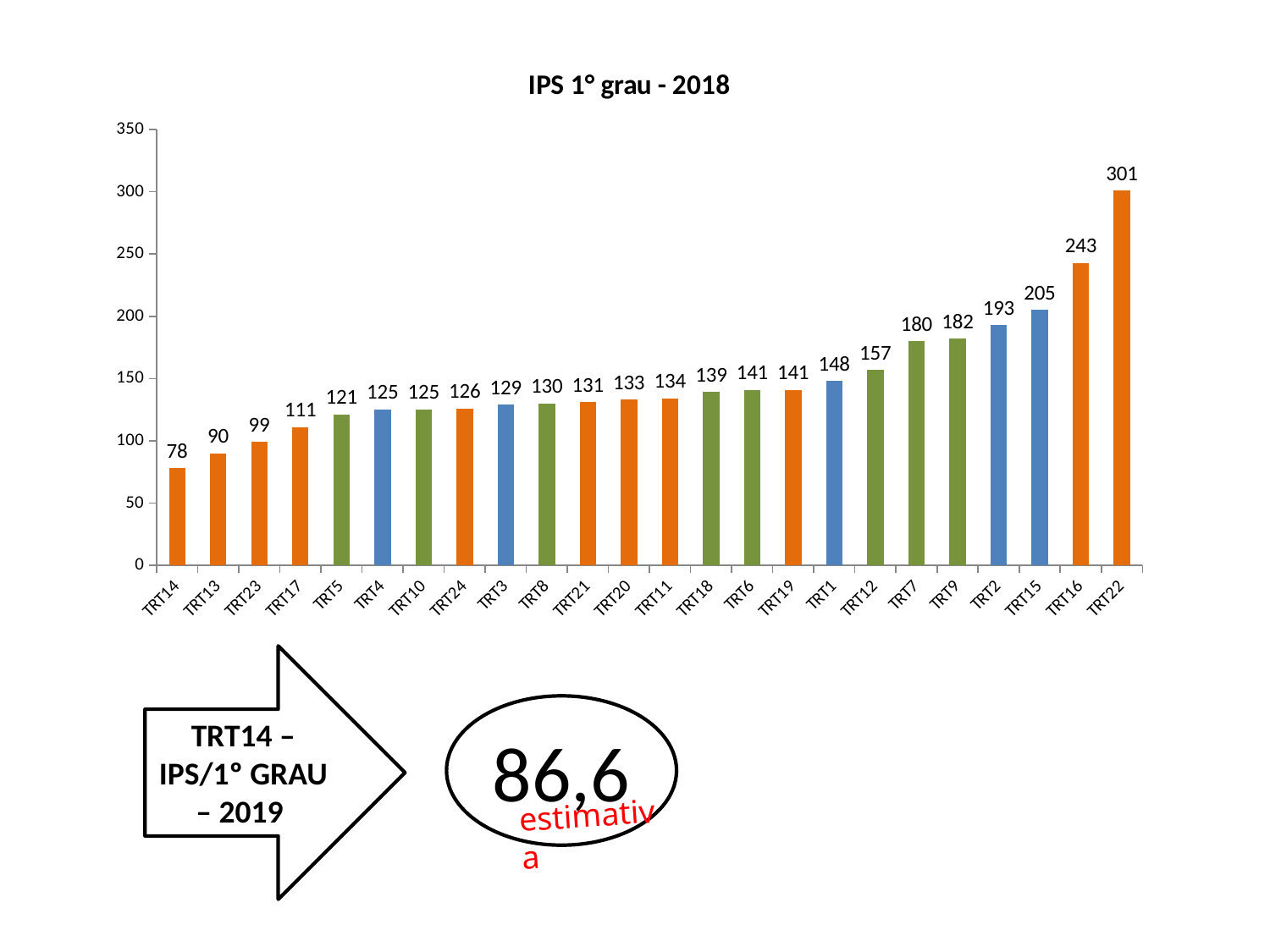
What is the value for TRT14 in the chart? 78 What is the difference between the values for TRT22 and TRT16? 58 What is the title of the chart? IPS 1° grau - 2018 What is the value for TRT1 in the chart? 148 Is the value for TRT12 greater or less than 150? greater Which category has the lowest value in the chart? TRT14 Which category has the highest value in the chart? TRT22 What is the value for TRT7 in the chart? 180 What is the value for TRT22 in the chart? 301 Which has a larger value, TRT15 or TRT2? TRT15 What kind of chart is shown on the slide? Bar chart How many categories are shown in the chart? 24